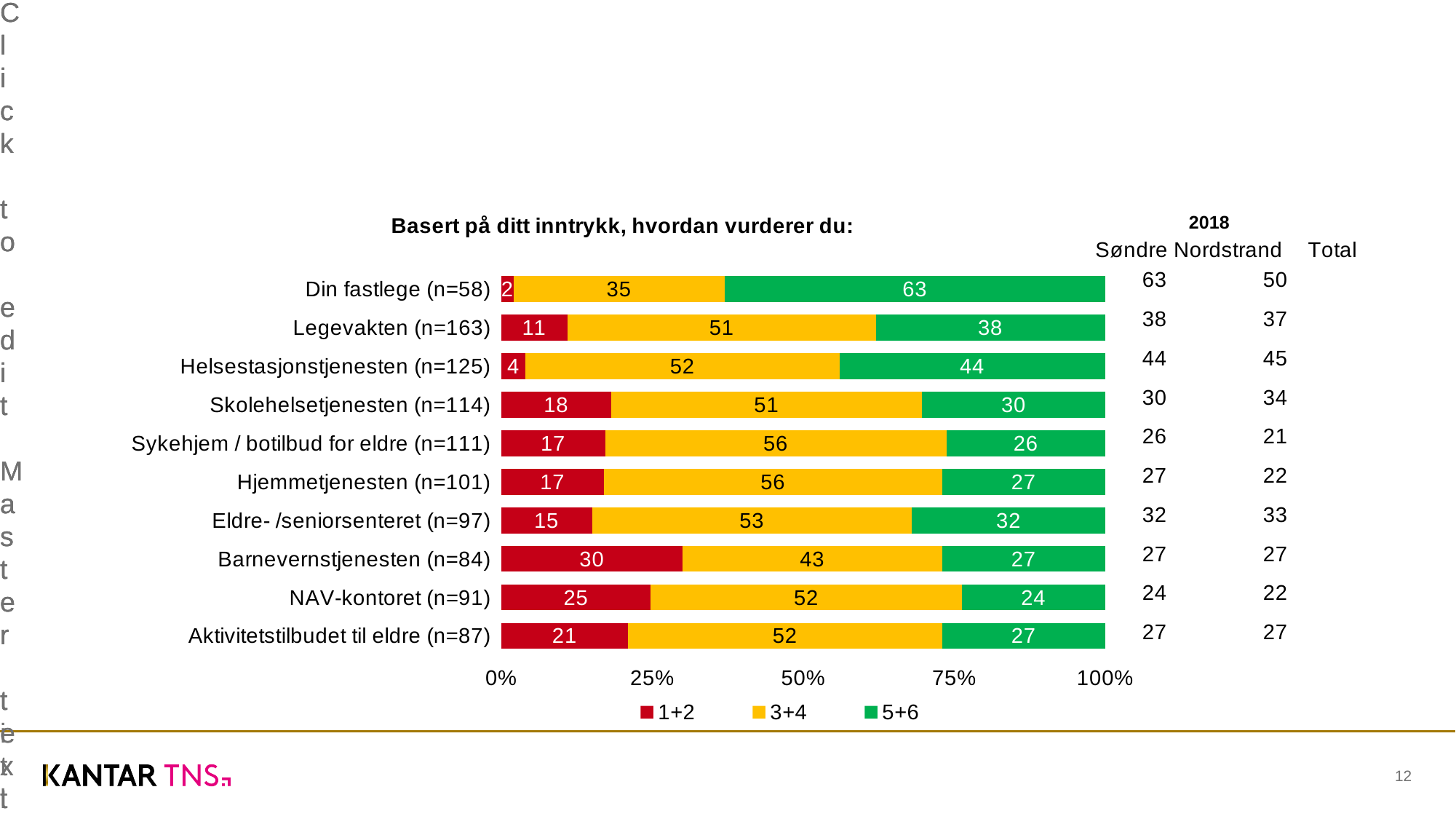
How many series does the legend list? 3 What is the value of the 3+4 series for Sykehjem / botilbud for eldre (n=111)? 56 How many categories are shown in the chart? 10 Which category has the highest value in the 1+2 series? Barnevernstjenesten (n=84) Which is larger: the 1+2 value for NAV-kontoret (n=91) or the 1+2 value for Aktivitetstilbudet til eldre (n=87)? NAV-kontoret (n=91) Which category has the highest value in the 5+6 series? Din fastlege (n=58) What is the value of the 5+6 series for Din fastlege (n=58)? 63 Which category has the lowest value in the 1+2 series? Din fastlege (n=58) What is the value of the 1+2 series for Barnevernstjenesten (n=84)? 30 What kind of chart is shown on the slide? Stacked bar chart What is the title of the chart? Basert på ditt inntrykk, hvordan vurderer du: What is the difference between the 5+6 values for Legevakten (n=163) and Skolehelsetjenesten (n=114)? 8